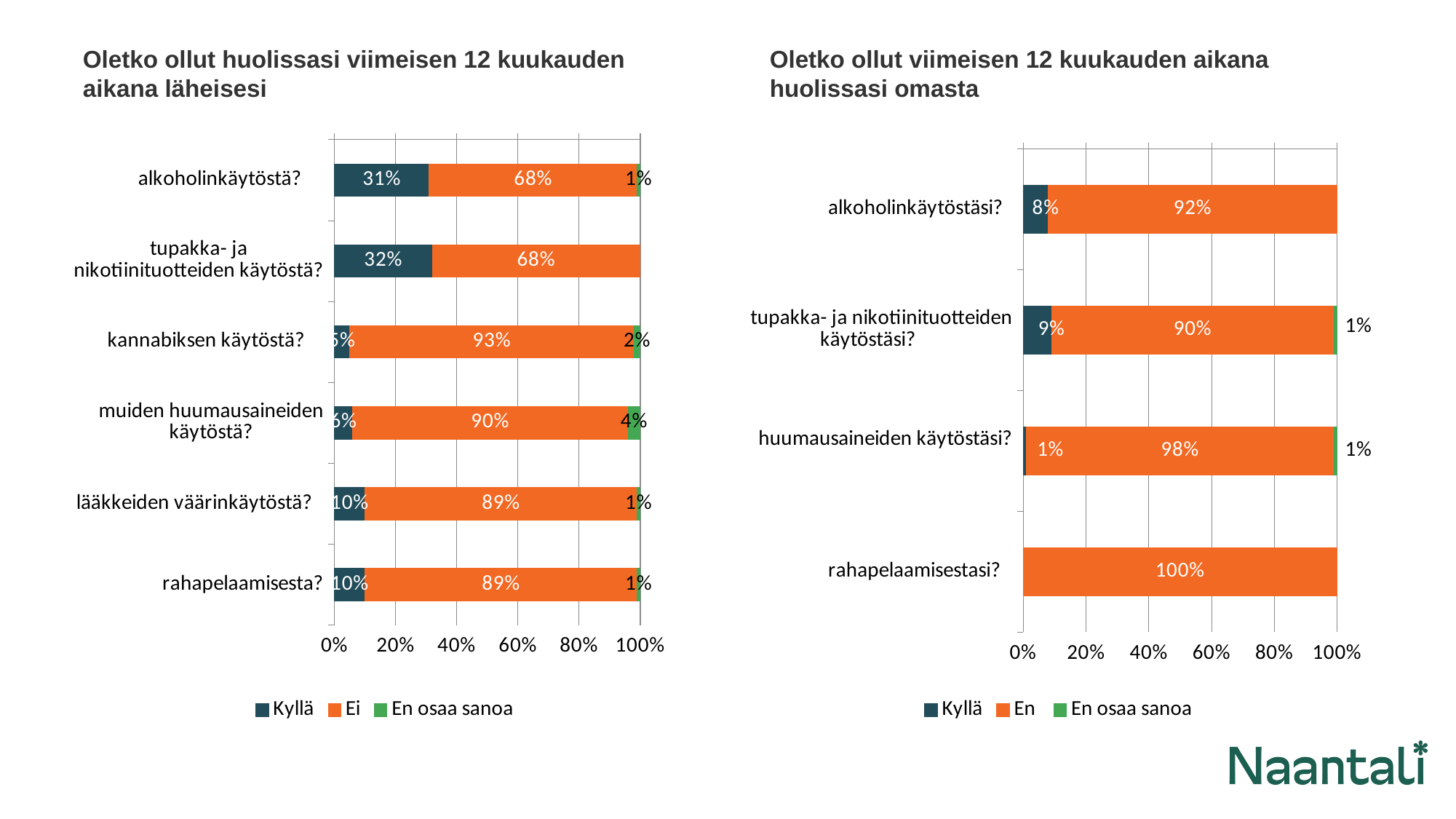
In the left chart ("Oletko ollut huolissasi viimeisen 12 kuukauden aikana läheisesi"), what is the Kyllä value for alkoholinkäytöstä? 31% In the right chart ("Oletko ollut viimeisen 12 kuukauden aikana huolissasi omasta"), which category has the highest En value? rahapelaamisestasi In the right chart ("Oletko ollut viimeisen 12 kuukauden aikana huolissasi omasta"), what is the En value for alkoholinkäytöstäsi? 92% In the left chart ("Oletko ollut huolissasi viimeisen 12 kuukauden aikana läheisesi"), what is the difference between the Ei value for lääkkeiden väärinkäytöstä and the Ei value for alkoholinkäytöstä? 21% In the right chart ("Oletko ollut viimeisen 12 kuukauden aikana huolissasi omasta"), what is the Kyllä value for tupakka- ja nikotiinituotteiden käytöstäsi? 9% In the right chart ("Oletko ollut viimeisen 12 kuukauden aikana huolissasi omasta"), which is larger: the Kyllä value for alkoholinkäytöstäsi or the Kyllä value for huumausaineiden käytöstäsi? alkoholinkäytöstäsi What kind of chart is the right chart ("Oletko ollut viimeisen 12 kuukauden aikana huolissasi omasta")? Stacked bar chart In the left chart ("Oletko ollut huolissasi viimeisen 12 kuukauden aikana läheisesi"), what is the En osaa sanoa value for muiden huumausaineiden käytöstä? 4% In the left chart ("Oletko ollut huolissasi viimeisen 12 kuukauden aikana läheisesi"), what is the Ei value for kannabiksen käytöstä? 93% In the right chart ("Oletko ollut viimeisen 12 kuukauden aikana huolissasi omasta"), how many series does the legend list? 3 In the left chart ("Oletko ollut huolissasi viimeisen 12 kuukauden aikana läheisesi"), which category has the highest Kyllä value? tupakka- ja nikotiinituotteiden käytöstä In the left chart ("Oletko ollut huolissasi viimeisen 12 kuukauden aikana läheisesi"), how many categories are shown? 6